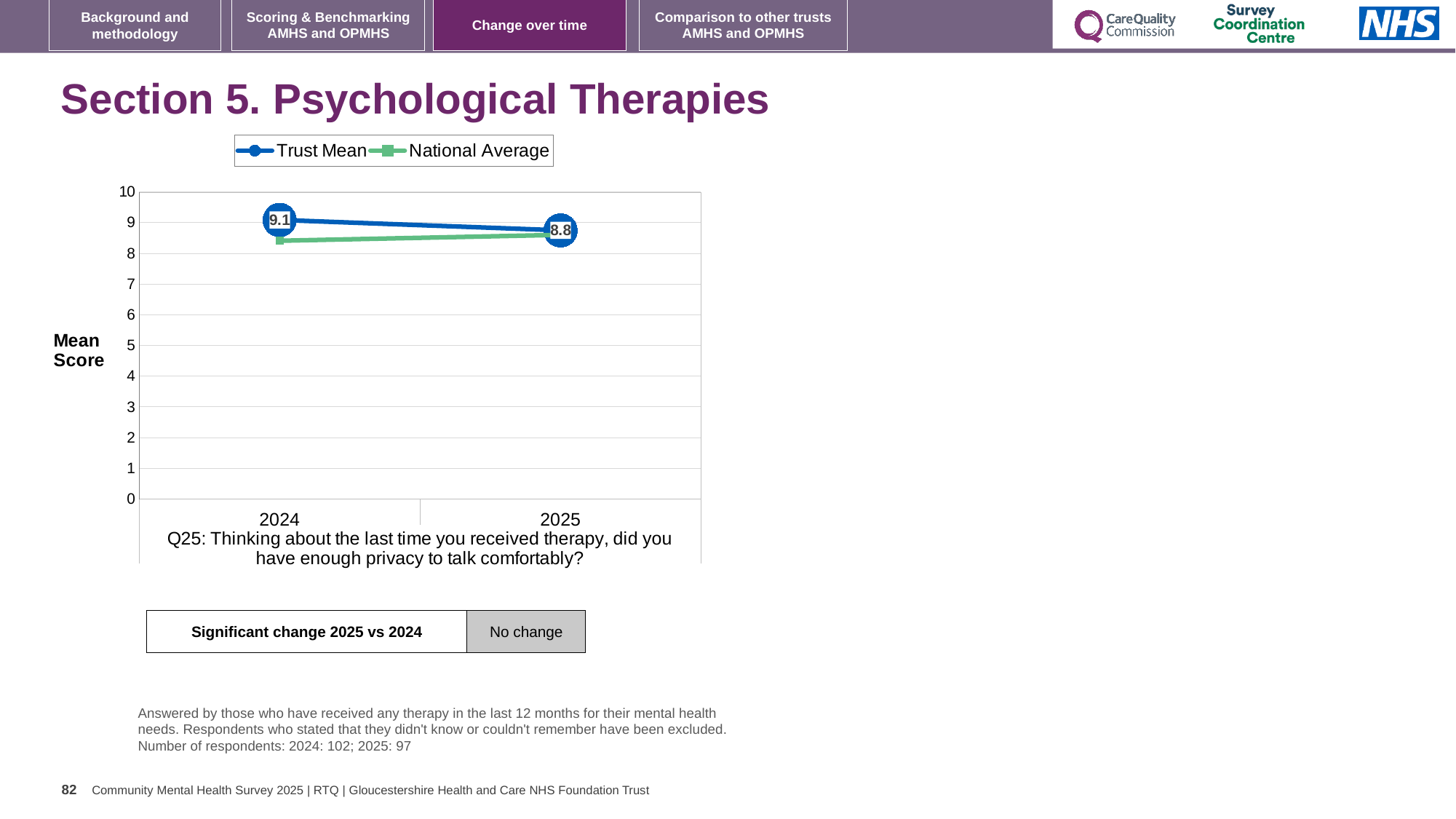
Which year has the higher Trust Mean, 2024 or 2025? 2024 What is the Trust Mean value for 2025? 8.8 What kind of chart is shown on the slide? line chart How many series does the legend list? 2 By how much did the Trust Mean change from 2024 to 2025? 0.3 What is the label on the y axis of the chart? Mean Score Does the Trust Mean rise or fall from 2024 to 2025? fall Does the National Average rise or fall from 2024 to 2025? rise Is the National Average value for 2024 greater or less than 9? less What is the Trust Mean value for 2024? 9.1 How many years are plotted on the x axis? 2 In 2024, which is higher, the Trust Mean or the National Average? Trust Mean